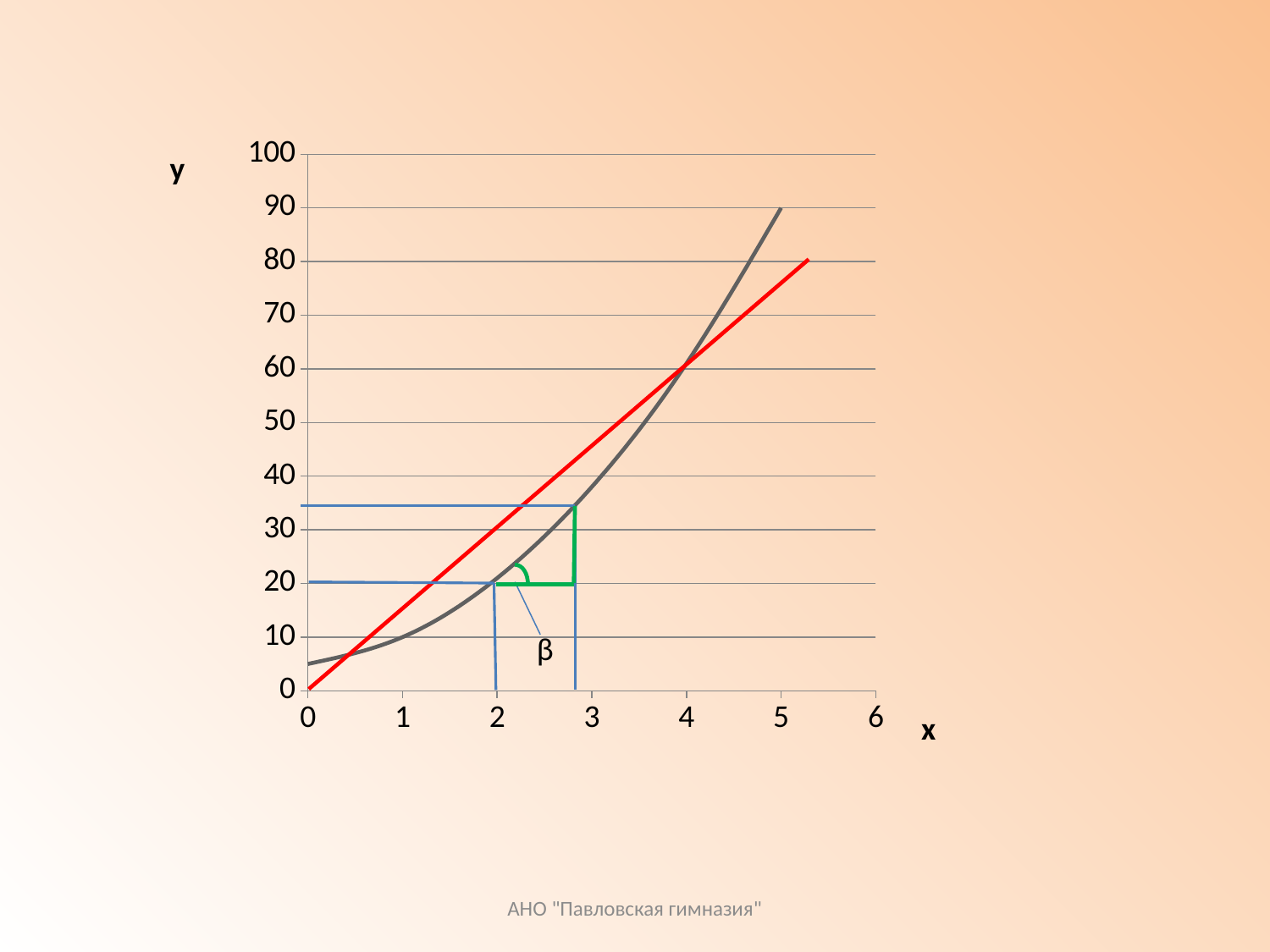
What is the highest value shown on the y axis? 100 At x = 1, which is higher: the gray curve or the red straight line? the red straight line Is the value of the gray curve at x = 5 greater or less than 80? greater Is the value of the gray curve at x = 2 greater or less than 30? less Is the value of the red straight line at x = 1 greater or less than 10? greater What type of chart is shown on the slide? line chart Do the values of the gray curve rise or fall as x increases? rise At x = 5, which is higher: the gray curve or the red straight line? the gray curve Do the values of the red straight line rise or fall as x increases? rise What is the highest value shown on the x axis? 6